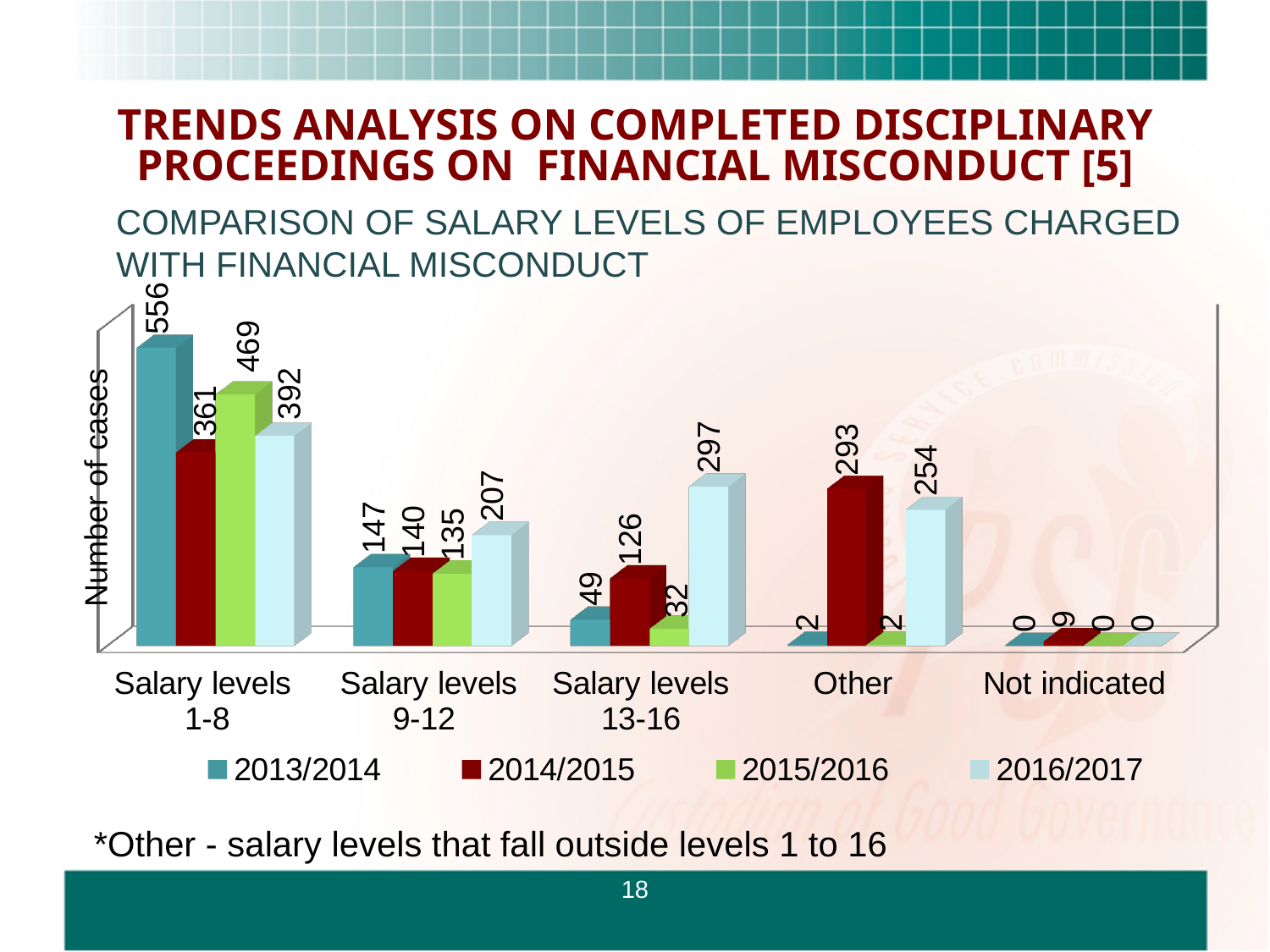
How many categories are shown on the x axis? 5 How many series does the legend list? 4 What is the value for Salary levels 1-8 in the 2013/2014 series? 556 What is the value for Salary levels 9-12 in the 2015/2016 series? 135 What is the difference between the 2013/2014 and 2014/2015 values for Salary levels 1-8? 195 What is the value for Other in the 2014/2015 series? 293 Which is larger for Salary levels 13-16: the 2014/2015 value or the 2016/2017 value? 2016/2017 Which category has the highest value in the 2013/2014 series? Salary levels 1-8 What is the value for Salary levels 13-16 in the 2016/2017 series? 297 Which category has the lowest value in the 2016/2017 series? Not indicated What kind of chart is shown on the slide? Bar chart What is the label of the vertical axis? Number of cases